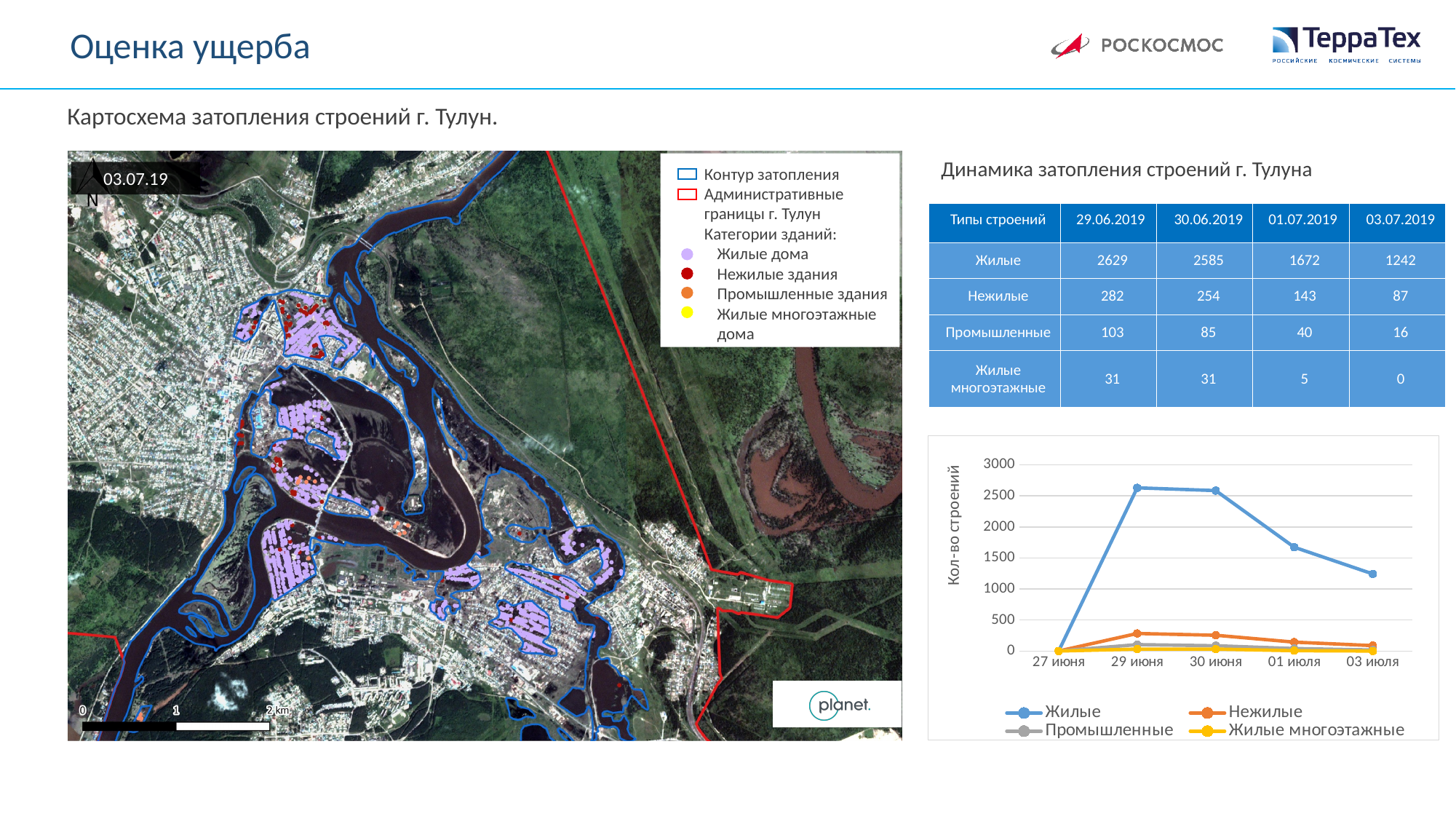
According to the table, which building type has the lowest value on 03.07.2019? Жилые многоэтажные In the line chart, is the value for Жилые on 29 июня greater or less than 2500? greater In the line chart, which series has the highest value on 29 июня? Жилые According to the table, what is the difference between the Жилые values on 29.06.2019 and 03.07.2019? 1387 In the line chart, which is larger on 30 июня: Нежилые or Промышленные? Нежилые According to the table, how many Жилые buildings were flooded on 01.07.2019? 1672 How many dates are shown along the x axis of the line chart? 5 What kind of chart is shown under the table on the right side of the slide? line chart In the line chart, does the Жилые series rise or fall from 29 июня to 03 июля? falls What is the label of the y axis of the line chart? Кол-во строений How many series does the legend of the line chart list? 4 In the line chart, is the value for Жилые on 03 июля greater or less than 1500? less